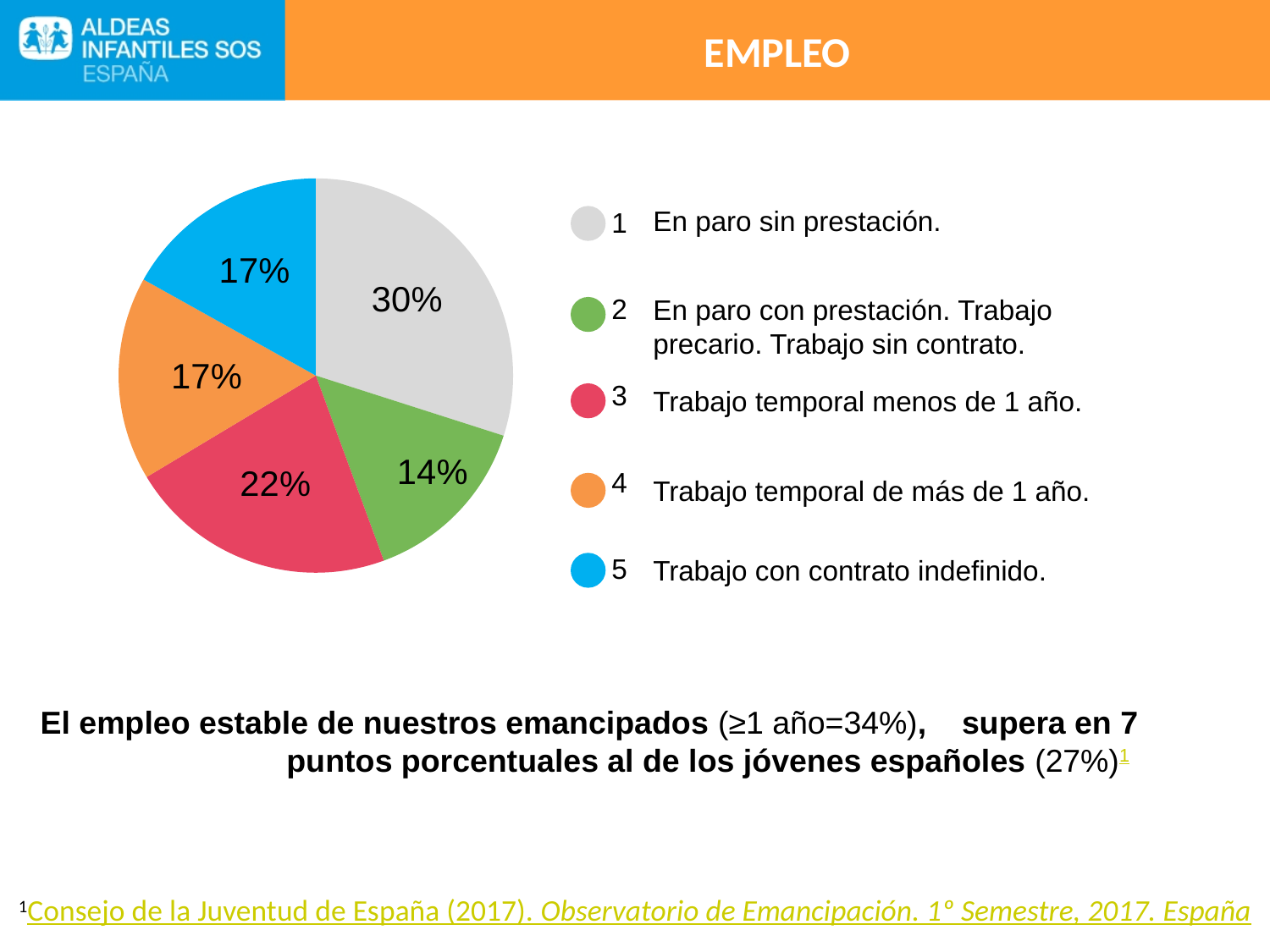
Which is larger: the share for "Trabajo temporal menos de 1 año" or the share for "Trabajo temporal de más de 1 año"? Trabajo temporal menos de 1 año What percentage of the pie corresponds to "En paro sin prestación"? 30% What percentage of the pie corresponds to "En paro con prestación. Trabajo precario. Trabajo sin contrato"? 14% What is the combined share of "Trabajo temporal de más de 1 año" and "Trabajo con contrato indefinido"? 34% What colour is the slice for "Trabajo temporal menos de 1 año"? Red What percentage of the pie corresponds to "Trabajo con contrato indefinido"? 17% What type of chart is shown on the slide? Pie chart What percentage of the pie corresponds to "Trabajo temporal menos de 1 año"? 22% Which category has the largest share of the pie? En paro sin prestación Which category has the smallest share of the pie? En paro con prestación. Trabajo precario. Trabajo sin contrato How many slices does the pie chart have? 5 What is the difference in percentage points between "En paro sin prestación" and "Trabajo temporal menos de 1 año"? 8